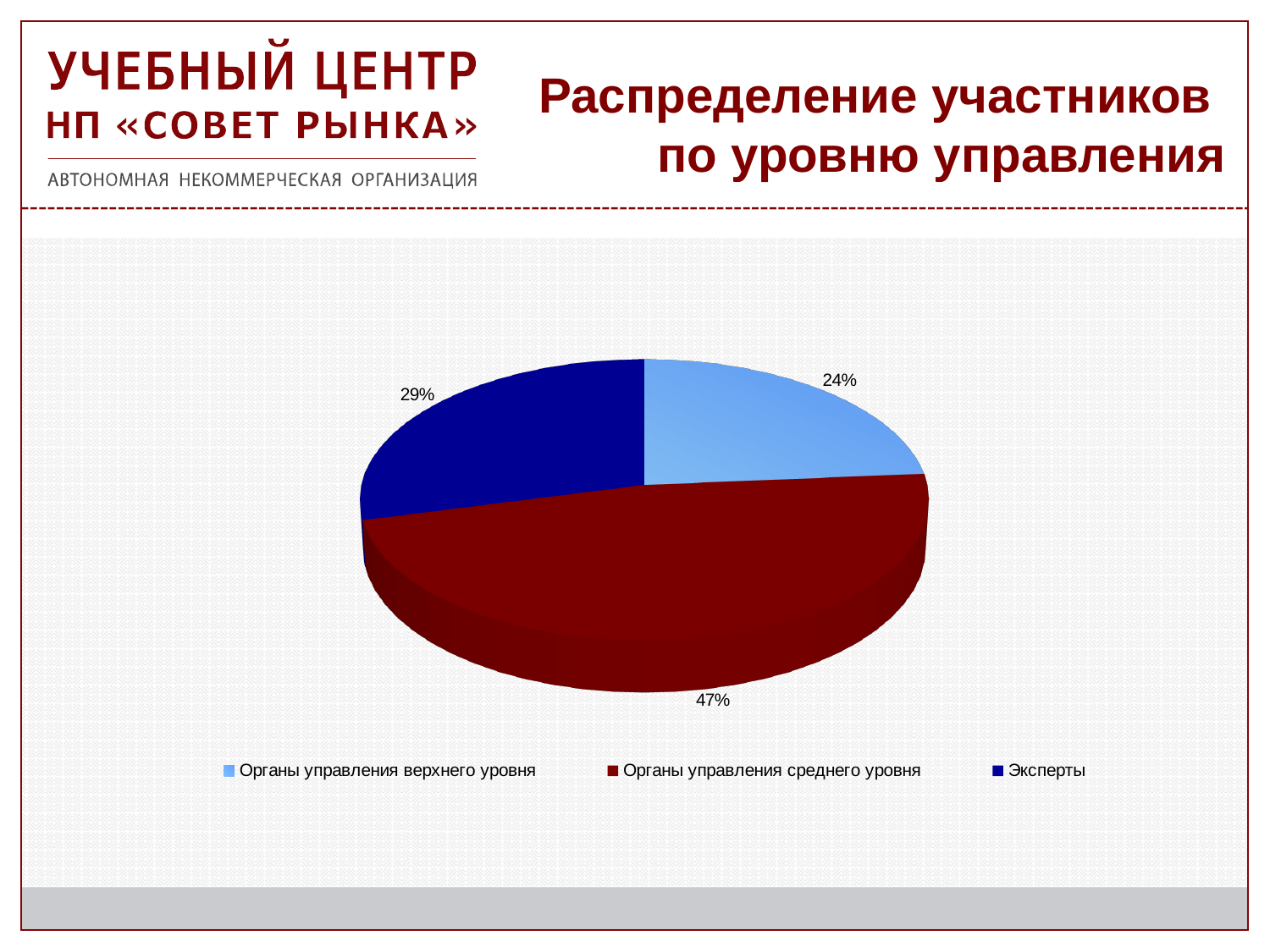
What is the difference in percentage points between Органы управления среднего уровня and Эксперты? 18 Which category has the smallest slice of the pie? Органы управления верхнего уровня Which category has the largest slice of the pie? Органы управления среднего уровня What share of participants is labelled for Органы управления среднего уровня? 47% What is the title of the chart on the slide? Распределение участников по уровню управления What share of participants is labelled for Органы управления верхнего уровня? 24% What kind of chart is shown on the slide? Pie chart What share of participants is labelled for Эксперты? 29% How many categories does the pie chart show? 3 What colour is the slice for Органы управления среднего уровня? Dark red Which is larger: the share for Эксперты or the share for Органы управления верхнего уровня? Эксперты What is the difference in percentage points between Эксперты and Органы управления верхнего уровня? 5